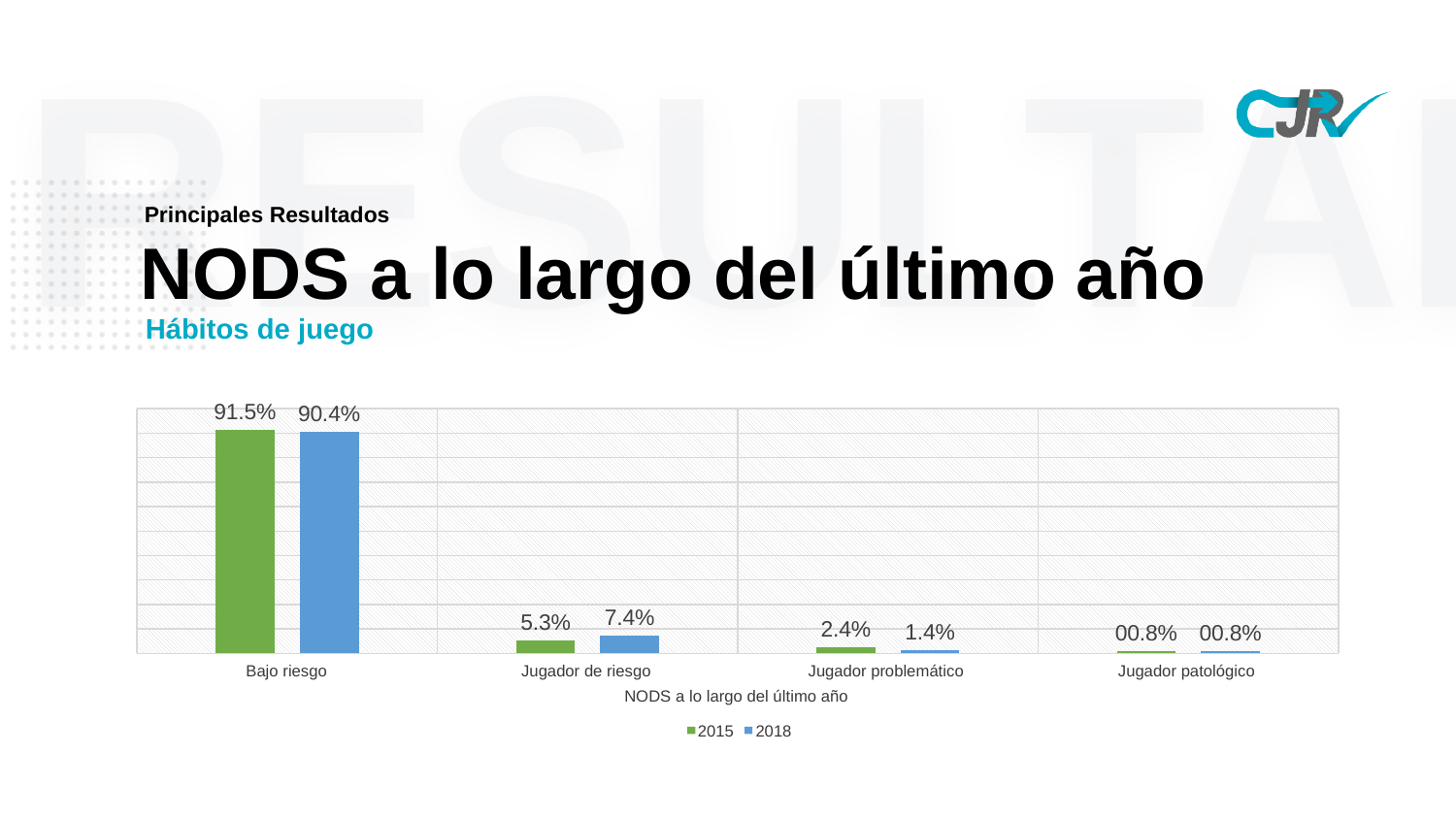
What is the 2015 value for Jugador patológico? 00.8% How many categories are shown on the x axis? 4 Which category has the highest 2018 value? Bajo riesgo Which category has the lowest 2015 value? Jugador patológico What is the 2018 value for Jugador de riesgo? 7.4% What is the difference between the 2015 and 2018 values for Bajo riesgo? 1.1% What is the 2015 value for Bajo riesgo? 91.5% What is the 2018 value for Jugador problemático? 1.4% What kind of chart is shown on the slide? Bar chart For Jugador problemático, which year has the larger value, 2015 or 2018? 2015 How many series does the legend list? 2 What is the difference between the 2018 and 2015 values for Jugador de riesgo? 2.1%